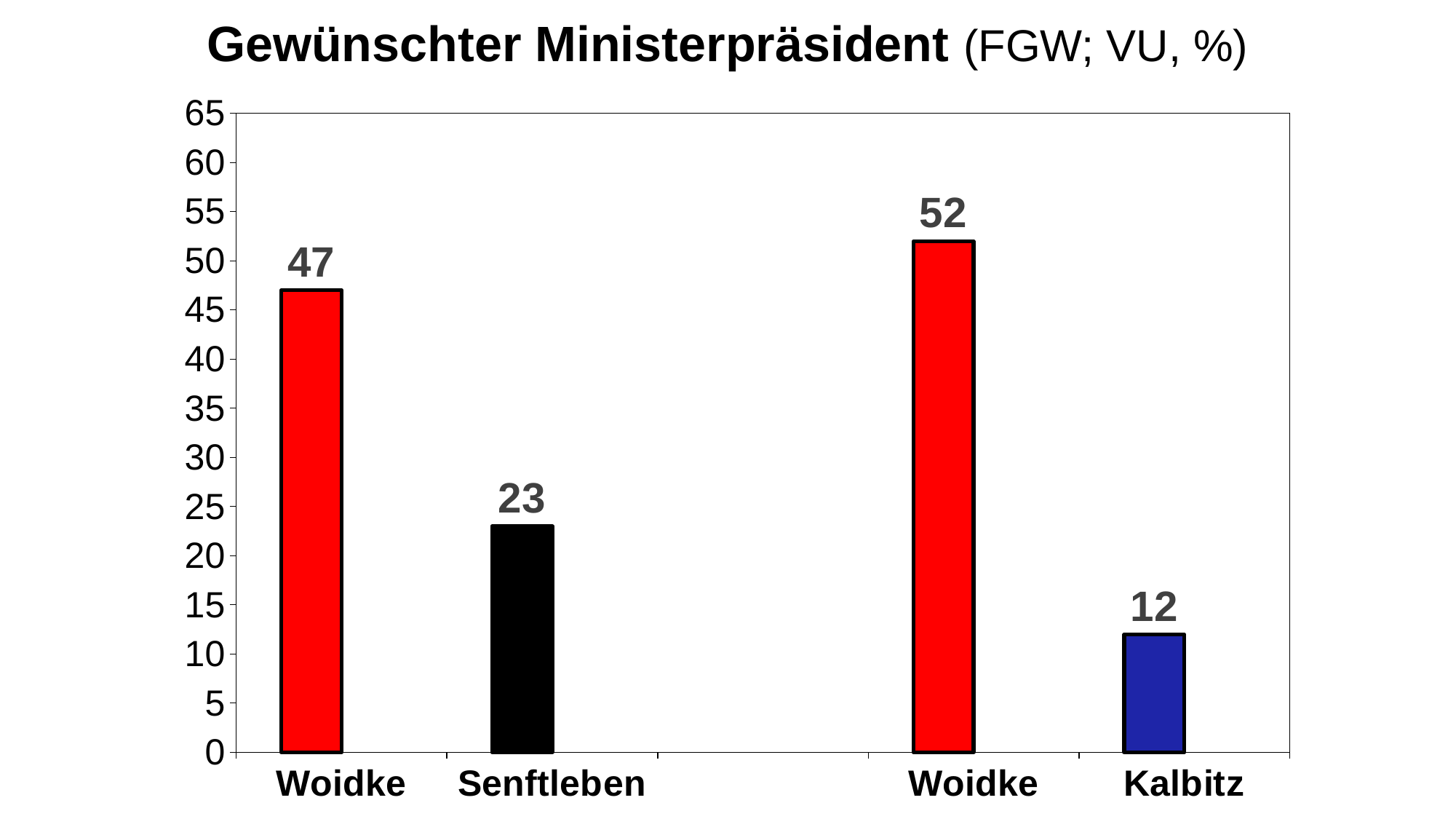
What is the difference between the Woidke bar next to Kalbitz and the Kalbitz bar? 40 What is the difference between the Woidke bar next to Senftleben and the Senftleben bar? 24 Which bar has the lowest value? Kalbitz How many bars are plotted on the chart? 4 What value is shown for Senftleben? 23 What value is shown for the Woidke bar in the right pair (next to Kalbitz)? 52 What kind of chart is shown? Bar chart What value is shown for Kalbitz? 12 Which is larger, the value for Senftleben or the value for Kalbitz? Senftleben What value is shown for the Woidke bar in the left pair (next to Senftleben)? 47 What colour is the Kalbitz bar? Blue Which bar has the highest value? Woidke (right pair, 52)